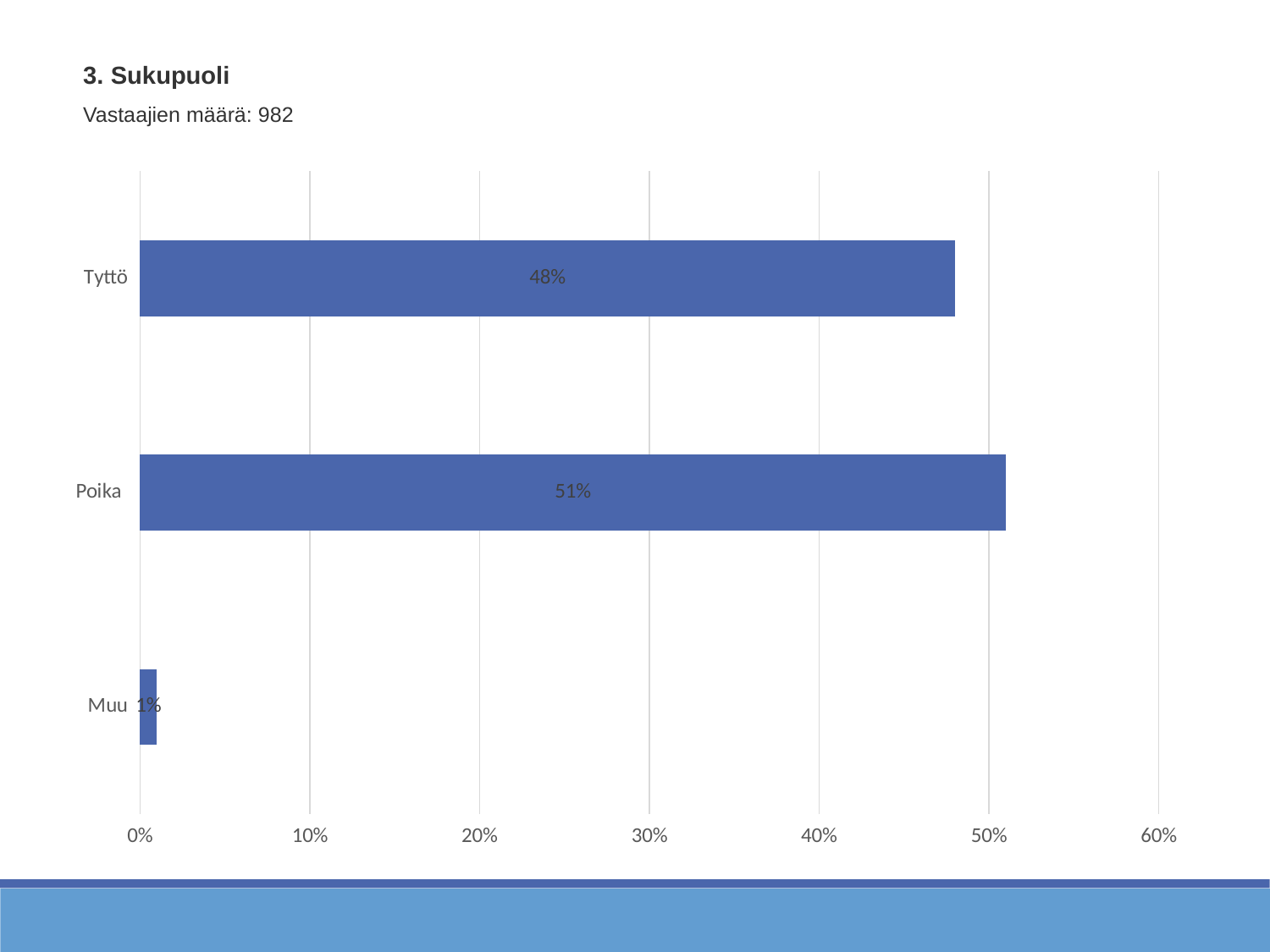
What is the value for Poika? 51% What kind of chart is shown on the slide? Bar chart Which category has the highest value? Poika Is the value for Tyttö greater or less than 50%? less What is the value for Tyttö? 48% What is the difference between the values for Poika and Tyttö? 3% What is the value for Muu? 1% Which category has the lowest value? Muu How many categories are shown in the chart? 3 What is the title of the chart? 3. Sukupuoli Is the value for Poika greater or less than 50%? greater Which is larger, the value for Tyttö or the value for Muu? Tyttö